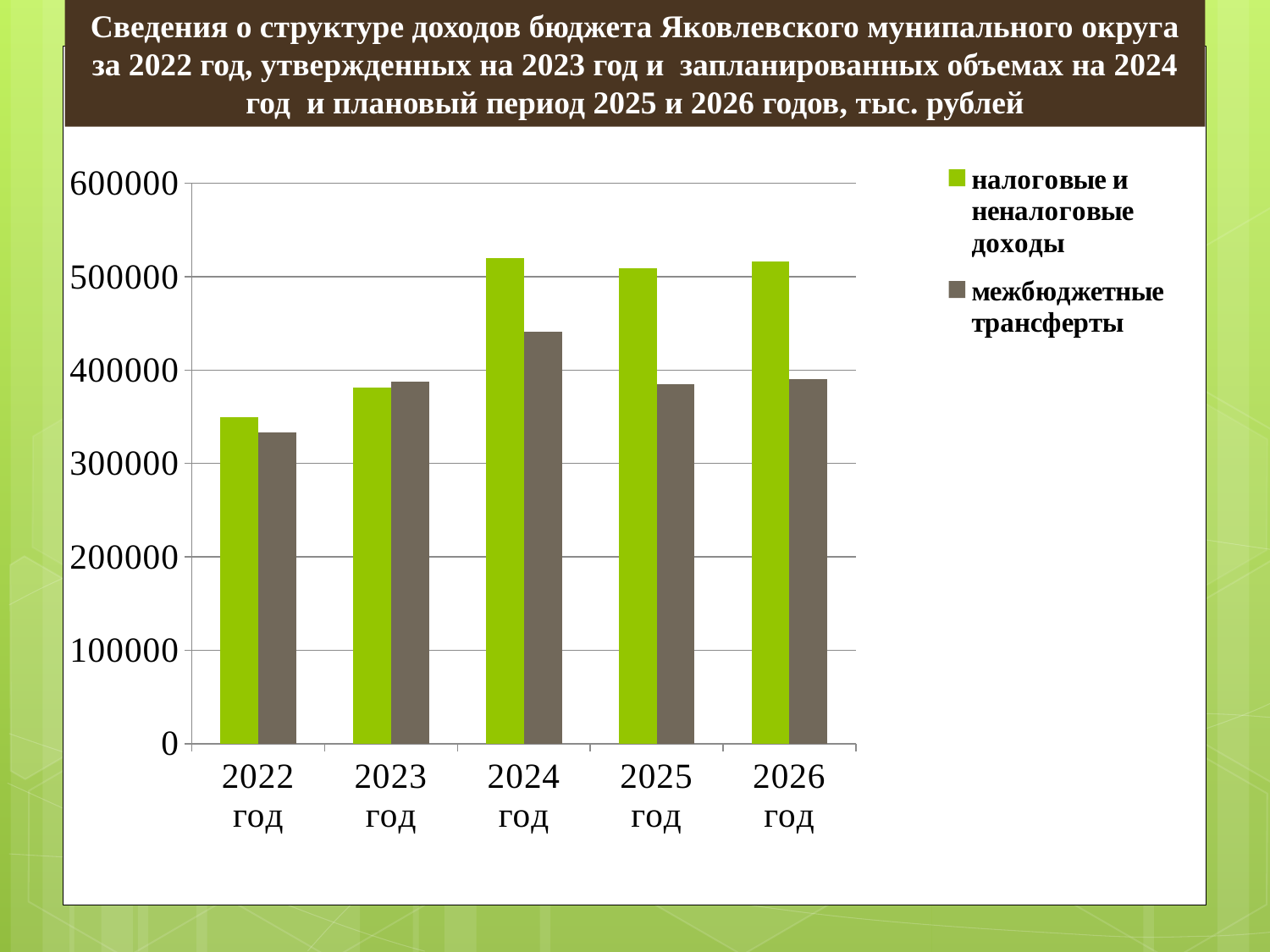
Which year has the lowest value for налоговые и неналоговые доходы? 2022 год Which year has the highest value for межбюджетные трансферты? 2024 год Is the value for налоговые и неналоговые доходы in 2023 год greater or less than 400000? less Do the values for налоговые и неналоговые доходы rise or fall from 2022 год to 2024 год? rise In 2024 год, which is larger: налоговые и неналоговые доходы or межбюджетные трансферты? налоговые и неналоговые доходы How many series does the legend list? 2 Which year has the lowest value for межбюджетные трансферты? 2022 год How many years (categories) are shown on the x axis? 5 Is the value for межбюджетные трансферты in 2024 год greater or less than 400000? greater Is the value for налоговые и неналоговые доходы in 2024 год greater or less than 500000? greater What kind of chart is shown on the slide? bar chart